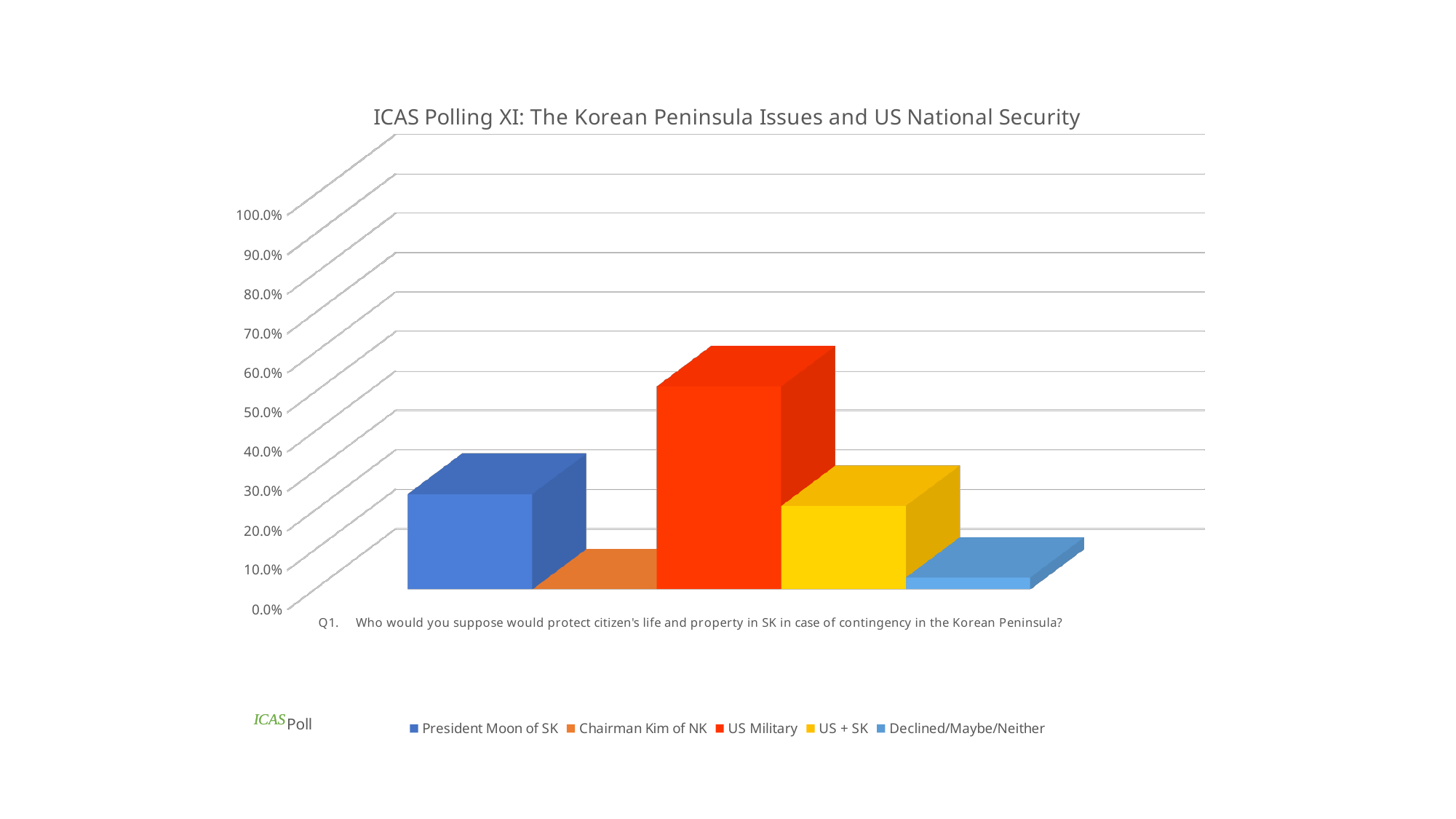
Which response has the highest value in the chart? US Military Is the value for US Military greater or less than 60.0%? less What kind of chart is shown on the slide? bar chart Which colour represents US + SK in the legend? yellow What is the title of the chart? ICAS Polling XI: The Korean Peninsula Issues and US National Security Is the value for US Military greater or less than 40.0%? greater Is the value for US + SK greater or less than 10.0%? greater Which is larger, the value for US Military or the value for President Moon of SK? US Military How many series does the legend list? 5